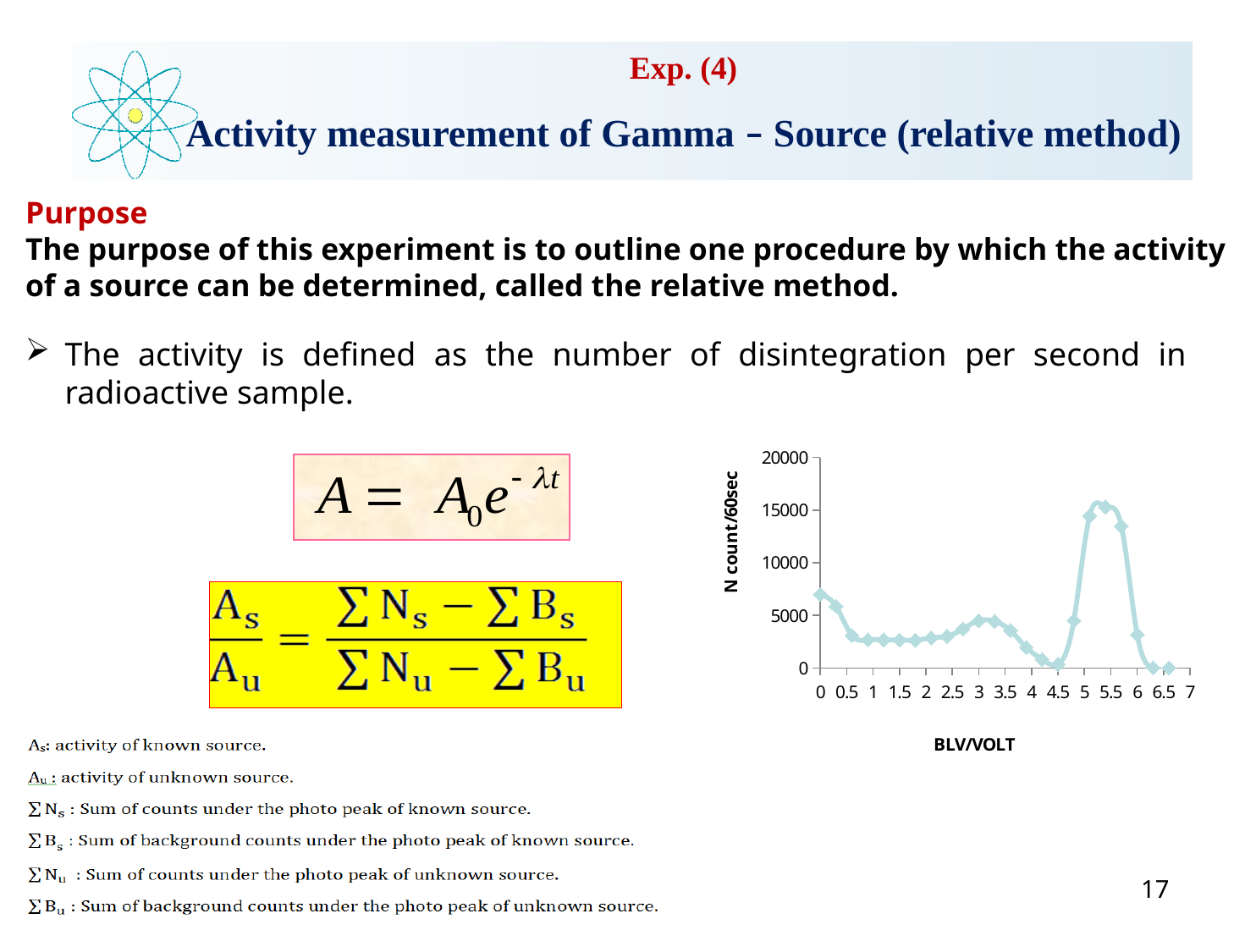
Do the values rise or fall as BLV/VOLT goes from 4.5 to 5.5? rise What is the label of the x axis of the chart? BLV/VOLT What is the label of the y axis of the chart? N count/60sec Is the value at BLV/VOLT = 4.5 greater or less than 5000? less Which is larger, the value at BLV/VOLT = 5.5 or the value at BLV/VOLT = 3? 5.5 Is the value at BLV/VOLT = 5.5 greater or less than 10000? greater Do the values rise or fall as BLV/VOLT goes from 0 to 1? fall Is the value at BLV/VOLT = 0 greater or less than 5000? greater Do the values rise or fall as BLV/VOLT goes from 5.5 to 6.5? fall What kind of chart is shown on the slide? line chart